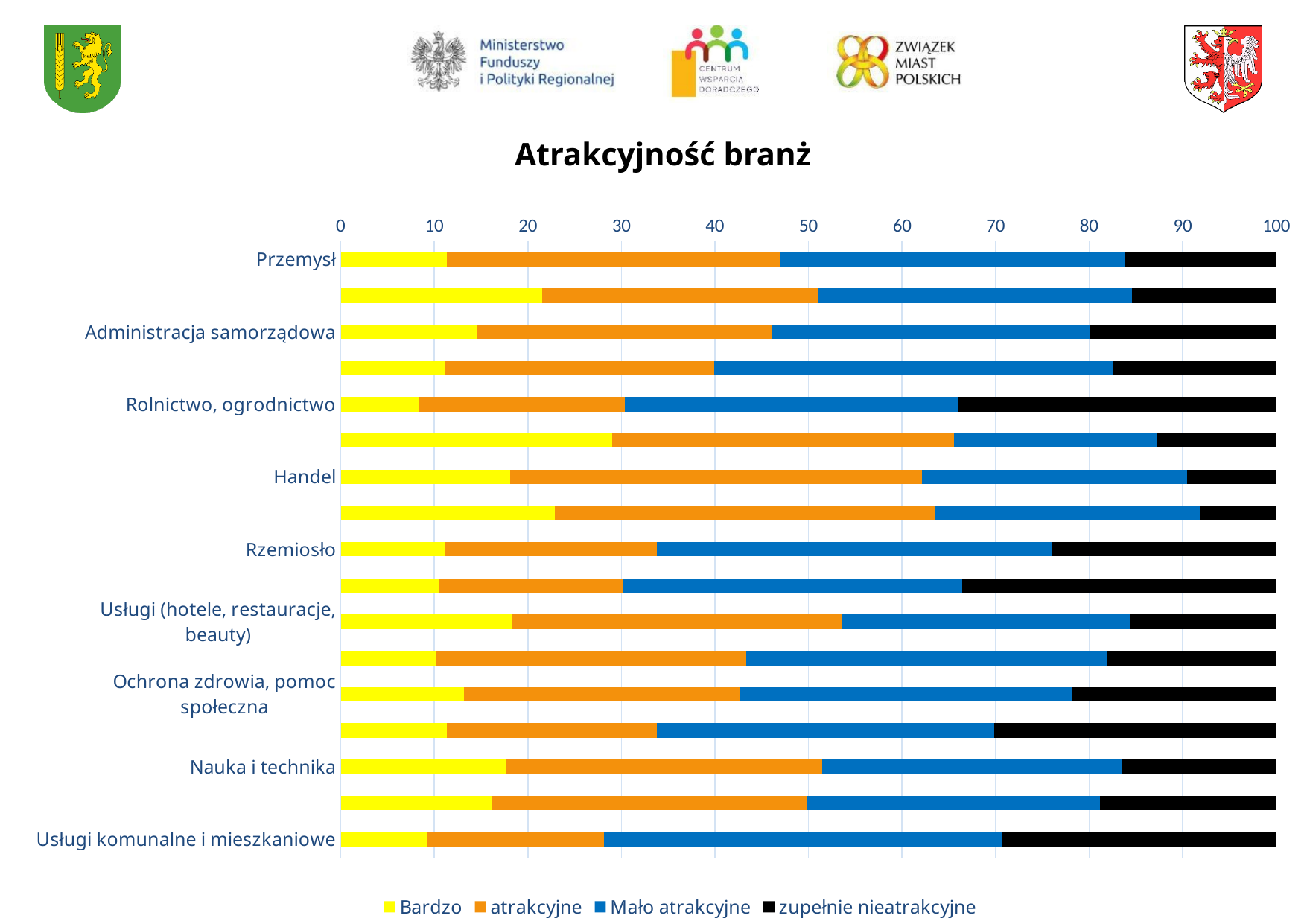
How many series does the legend list? 4 How many bars are plotted in the chart? 17 Which has the larger 'zupełnie nieatrakcyjne' value, Rolnictwo, ogrodnictwo or Handel? Rolnictwo, ogrodnictwo Is the 'atrakcyjne' value for Usługi komunalne i mieszkaniowe greater or less than 30? less Is the 'atrakcyjne' value for Handel greater or less than 40? greater Which has the larger 'Bardzo' value, Handel or Rolnictwo, ogrodnictwo? Handel What kind of chart is shown on the slide? stacked bar chart Is the 'Bardzo' value for Rolnictwo, ogrodnictwo greater or less than 10? less Which has the larger 'Bardzo' value, Nauka i technika or Usługi komunalne i mieszkaniowe? Nauka i technika Which legend entry is shown in black? zupełnie nieatrakcyjne What is the title of the chart? Atrakcyjność branż